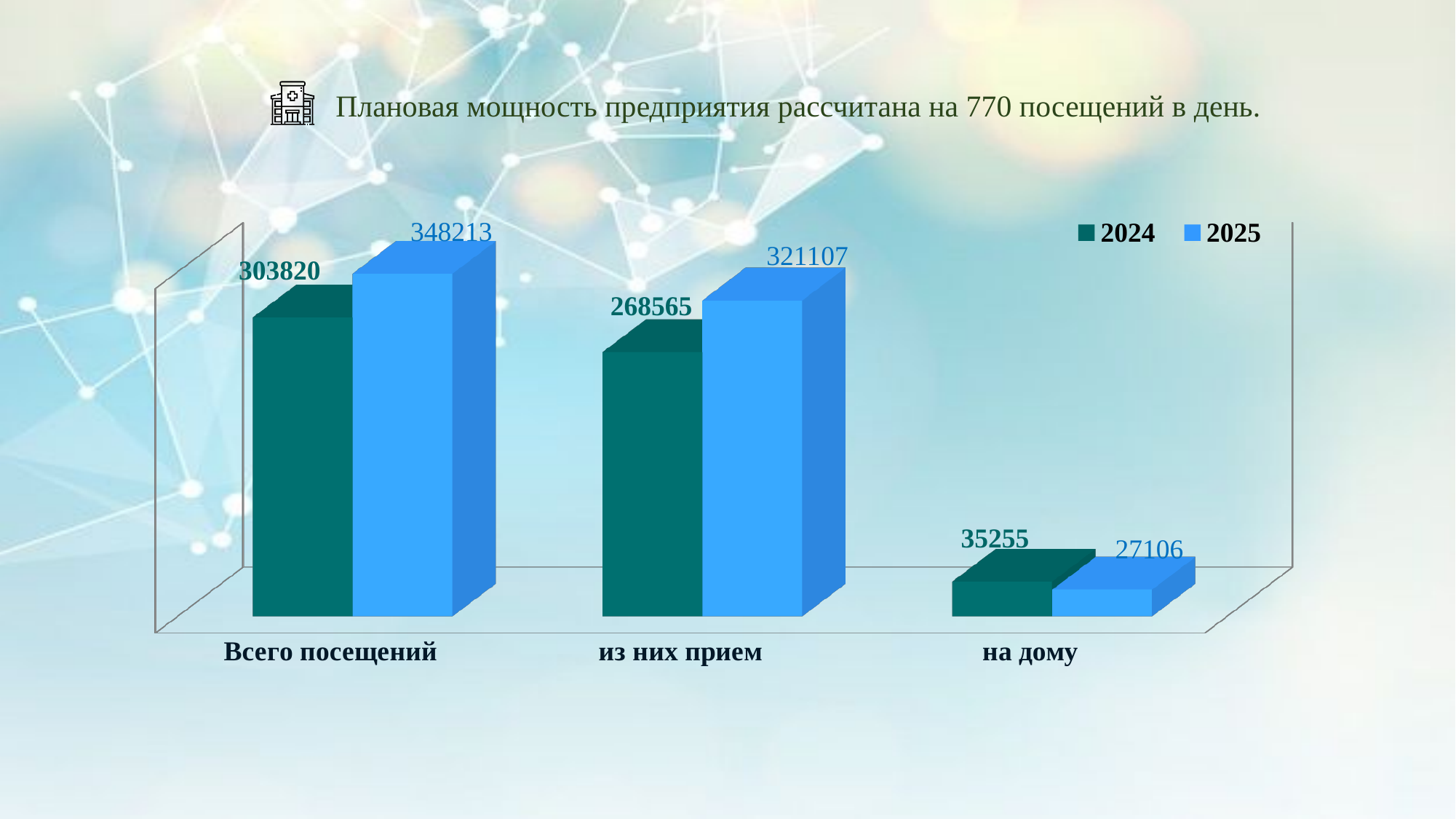
Which category has the highest value for the 2024 series? Всего посещений What is the value for 2025 in the "на дому" category? 27106 How many series does the legend list? 2 What is the difference between the 2025 and 2024 values for "Всего посещений"? 44393 What is the difference between the 2024 and 2025 values for "на дому"? 8149 Which is larger for "из них прием": the 2024 value or the 2025 value? 2025 What is the value for 2024 in the "на дому" category? 35255 What kind of chart is shown on the slide? bar chart How many categories are shown on the x axis? 3 What is the value for 2025 in the "Всего посещений" category? 348213 What is the value for 2024 in the "из них прием" category? 268565 Which category has the lowest value for the 2025 series? на дому